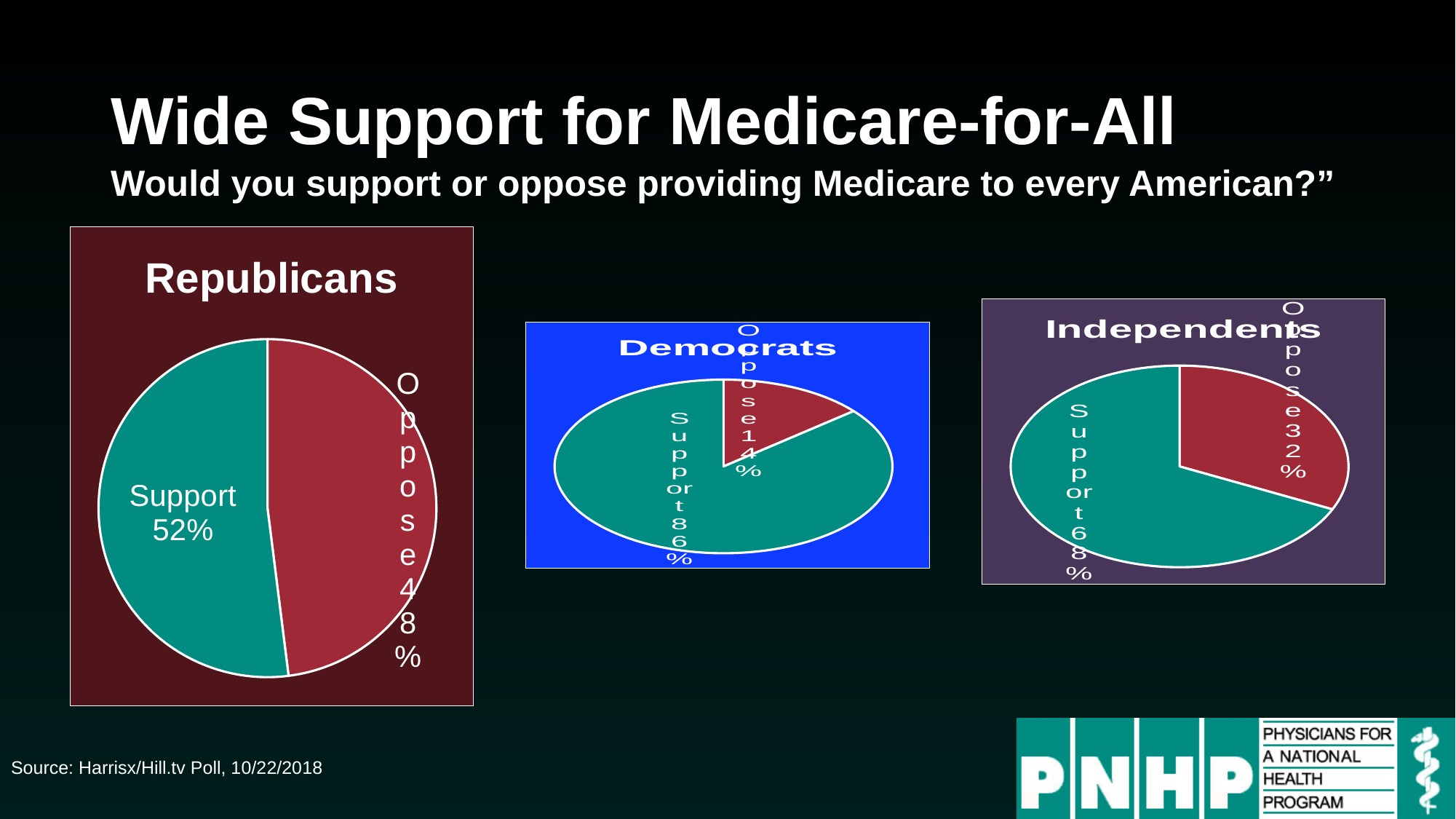
Across the three pie charts, which group has the lowest Support share? Republicans In the Independents chart, what share of respondents support? 68% In the Democrats chart, which slice is larger, Support or Oppose? Support In the Democrats chart, what share of respondents oppose? 14% How many slices does the Democrats pie chart have? 2 What kind of chart is used for the Republicans, Democrats and Independents data? Pie chart In the Independents chart, what share of respondents oppose? 32% In the Republicans chart, what share of respondents oppose? 48% In the Democrats chart, what share of respondents support? 86% In the Independents chart, what is the difference between the Support and Oppose shares? 36 percentage points Across the three pie charts, which group has the highest Support share? Democrats In the Republicans chart, what share of respondents support providing Medicare to every American? 52%